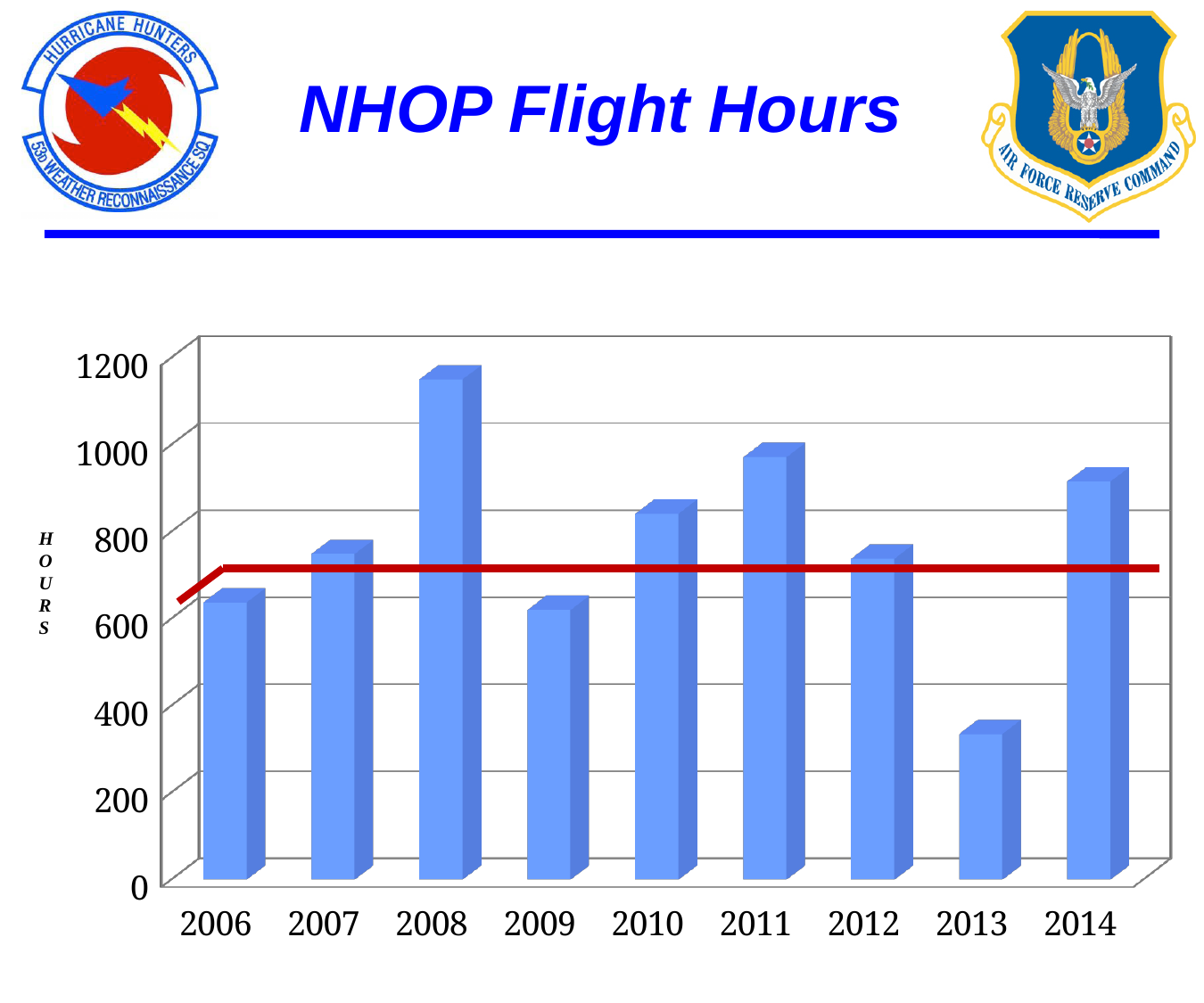
How many years are shown on the x axis of the chart? 9 Is the value for 2013 greater or less than 400? less What kind of chart is shown on the slide? bar chart Is the value for 2006 greater or less than 800? less Which year has more flight hours, 2009 or 2010? 2010 Is the value for 2011 greater or less than 800? greater What is the title of the chart on the slide? NHOP Flight Hours Which year has the lowest flight hours? 2013 Which year has the highest flight hours? 2008 Which year has more flight hours, 2008 or 2011? 2008